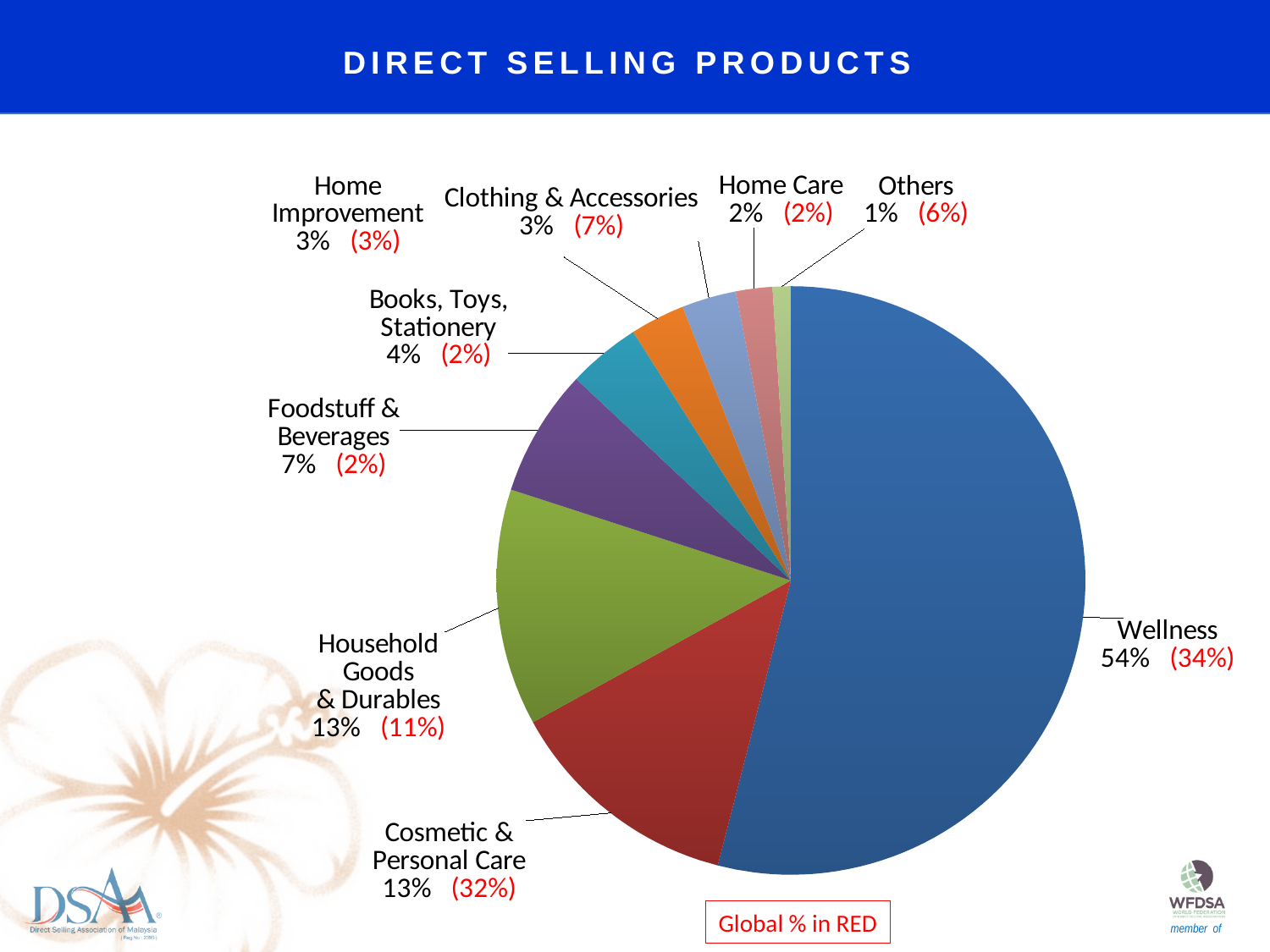
What is the difference between the Wellness share and the Household Goods & Durables share? 41% According to the note on the slide, what do the red percentages represent? Global % How many categories are shown in the pie chart? 9 Which category has the largest slice of the pie? Wellness What is the global percentage (shown in red) for Others? 6% What type of chart is shown on the slide? pie chart What is the global percentage (shown in red) for Wellness? 34% What share of the pie does Wellness hold? 54% Which category has the smallest slice of the pie? Others Which is larger: the share for Books, Toys, Stationery or the share for Home Care? Books, Toys, Stationery What share of the pie does Foodstuff & Beverages hold? 7% What is the global percentage (shown in red) for Cosmetic & Personal Care? 32%